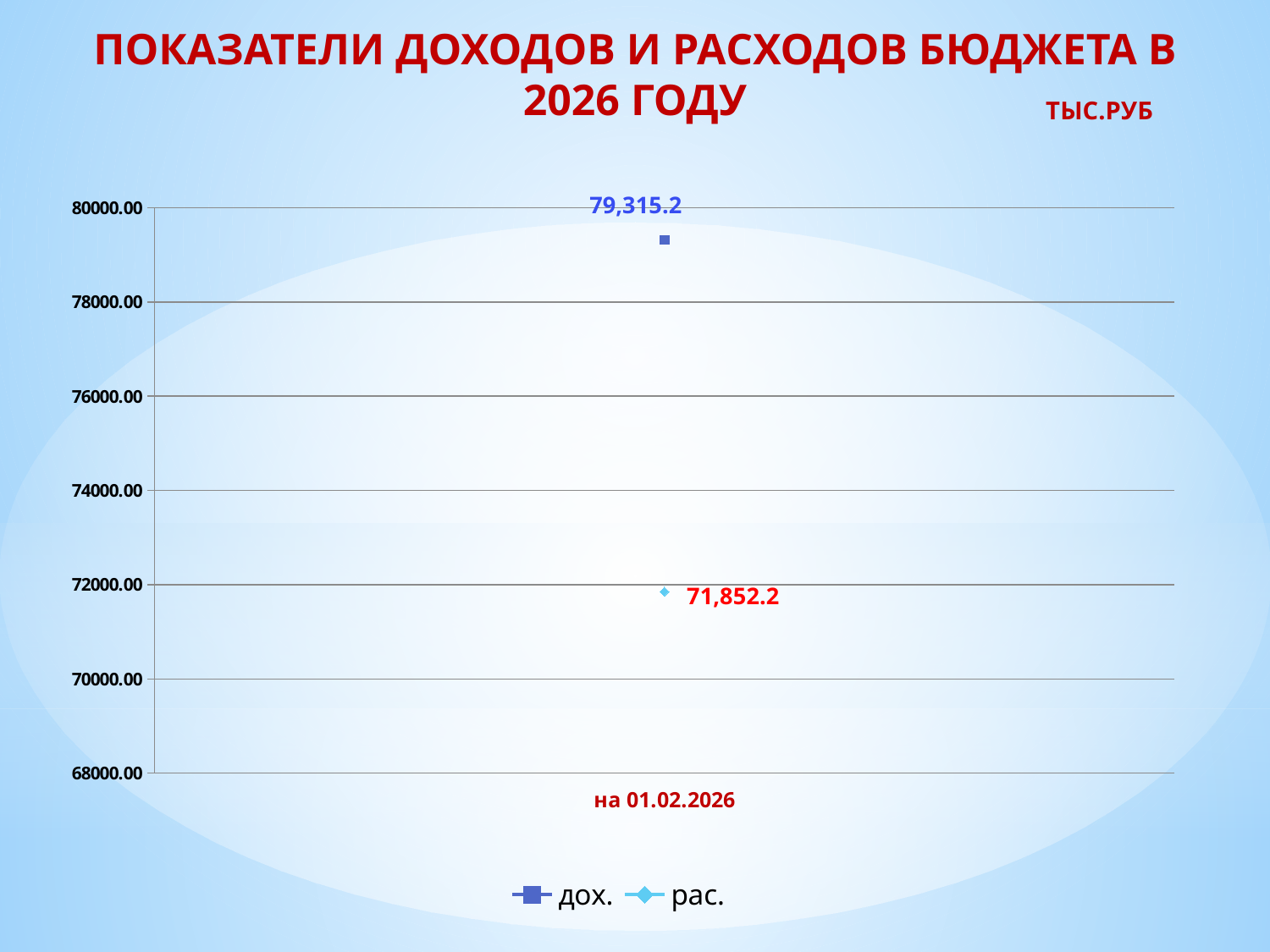
What is the value for the series "рас." at "на 01.02.2026"? 71,852.2 How many categories are shown on the x axis? 1 What is the value for the series "дох." at "на 01.02.2026"? 79,315.2 Is the value for "рас." greater or less than 72000.00? less Is the value for "дох." greater or less than 78000.00? greater Which series has the higher value at "на 01.02.2026", "дох." or "рас."? дох. What is the difference between the "дох." value and the "рас." value? 7,463.0 Which series has the highest plotted value? дох. How many series does the legend list? 2 Which series has the lowest plotted value? рас. What is the label of the single category on the x axis? на 01.02.2026 What unit is indicated for the values on the slide? ТЫС.РУБ